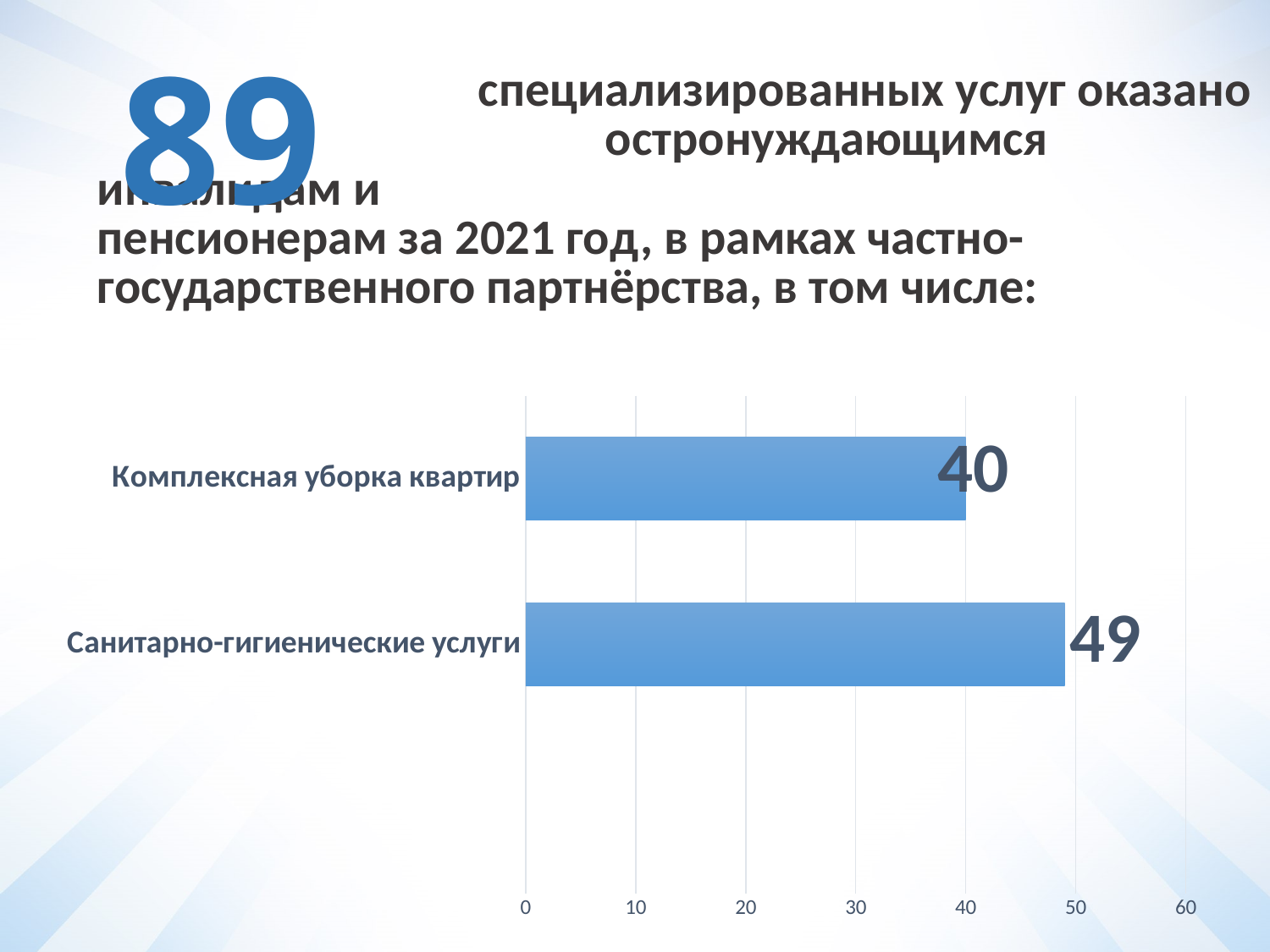
What is the difference between the values for Санитарно-гигиенические услуги and Комплексная уборка квартир? 9 Is the value for Комплексная уборка квартир greater or less than 50? less Is the value for Санитарно-гигиенические услуги greater or less than 30? greater Which category has the lowest value? Комплексная уборка квартир What is the value for Комплексная уборка квартир? 40 What is the maximum value shown on the horizontal axis of the chart? 60 Which category has the highest value? Санитарно-гигиенические услуги What kind of chart is shown on the slide? bar chart Which is larger: the value for Комплексная уборка квартир or the value for Санитарно-гигиенические услуги? Санитарно-гигиенические услуги What is the total of the two values shown in the chart? 89 How many categories are shown in the chart? 2 What is the value for Санитарно-гигиенические услуги? 49